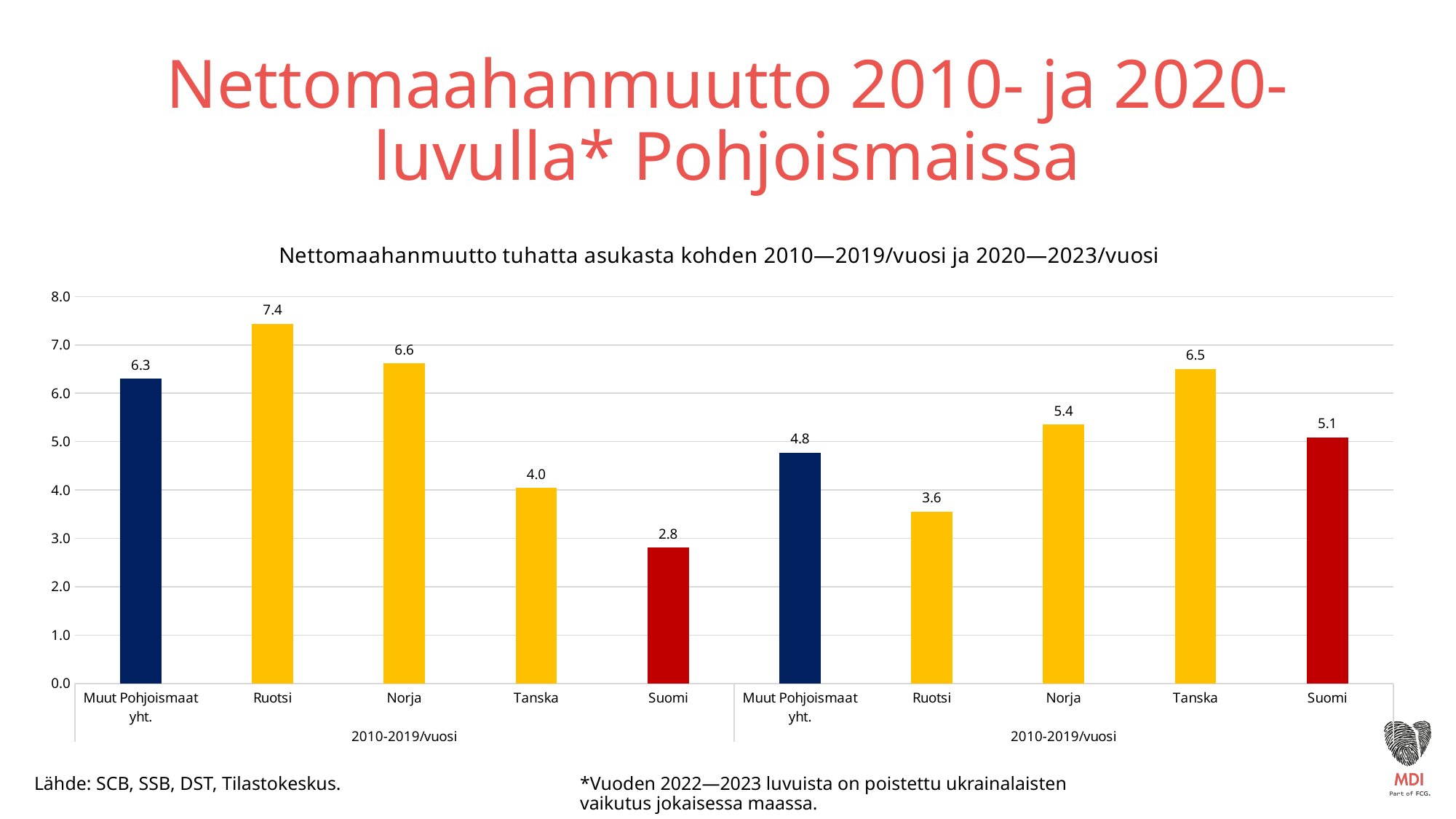
Which is larger: the value for Suomi in the left group or the value for Suomi in the right group? Suomi in the right group Is the value for Tanska in the left group greater or less than 5.0? less What is the value for Muut Pohjoismaat yht. in the right group of bars? 4.8 What is the value for Tanska in the right group of bars? 6.5 What kind of chart is shown on the slide? bar chart Which category has the lowest value in the right group of bars? Ruotsi How many bars are plotted in the chart in total? 10 What is the value for Suomi in the left group of bars? 2.8 What is the title of the chart? Nettomaahanmuutto tuhatta asukasta kohden 2010—2019/vuosi ja 2020—2023/vuosi What is the difference between the Norja values in the left group (6.6) and the right group (5.4)? 1.2 What is the value for Ruotsi in the left group of bars? 7.4 Which category has the highest value in the left group of bars? Ruotsi